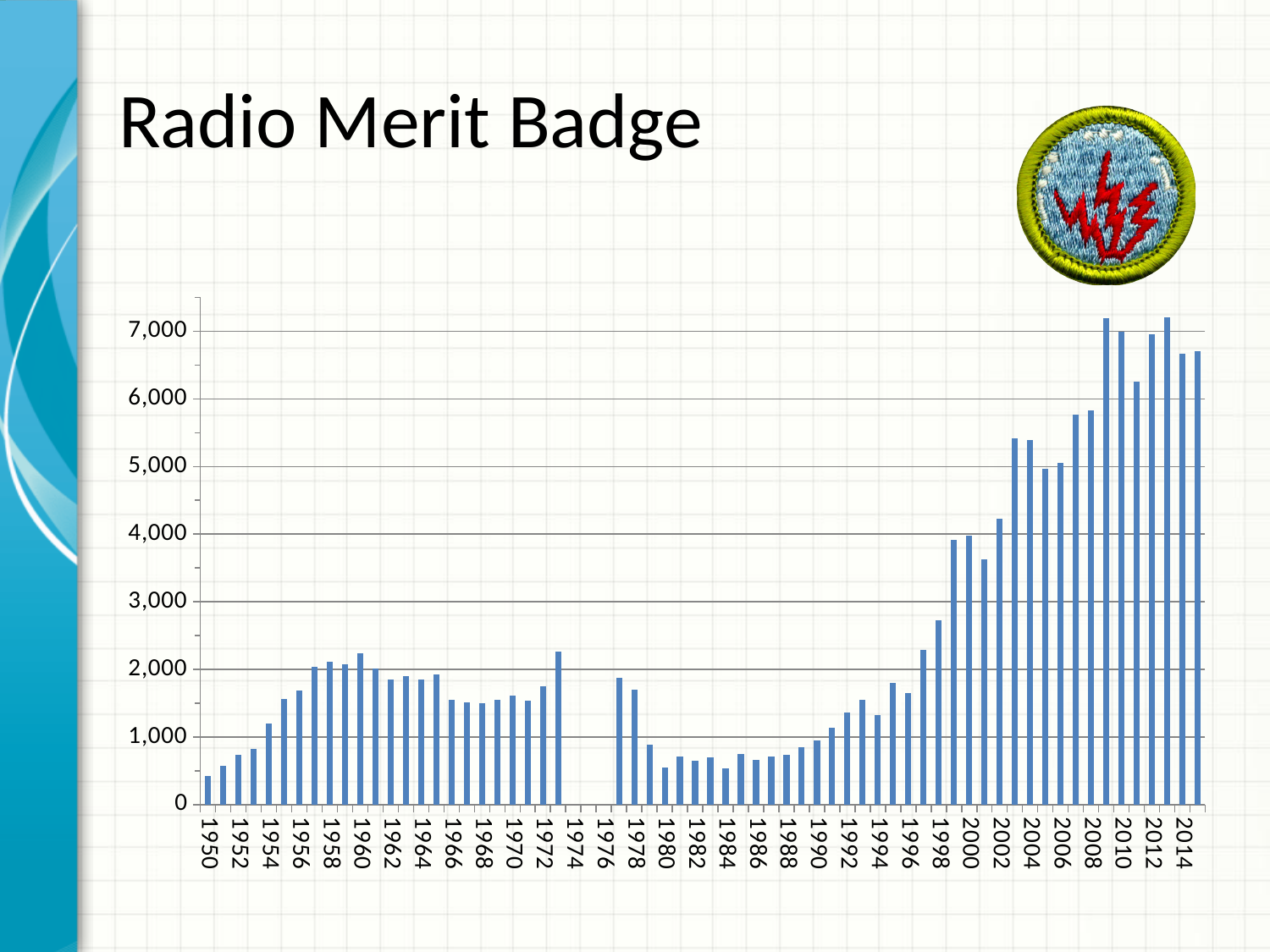
Is the value for 2014 greater or less than 6,000? greater Is the value for 2009 greater or less than 7,000? greater Is the value for 1960 greater or less than 2,000? greater What kind of chart is shown on the slide? bar chart Do the values generally rise or fall from 1996 to 2009? rise Which is larger, the value for 1960 or the value for 1980? 1960 What is the first year labeled on the x axis? 1950 Which is larger, the value for 2009 or the value for 1950? 2009 What is the title of the slide containing the chart? Radio Merit Badge